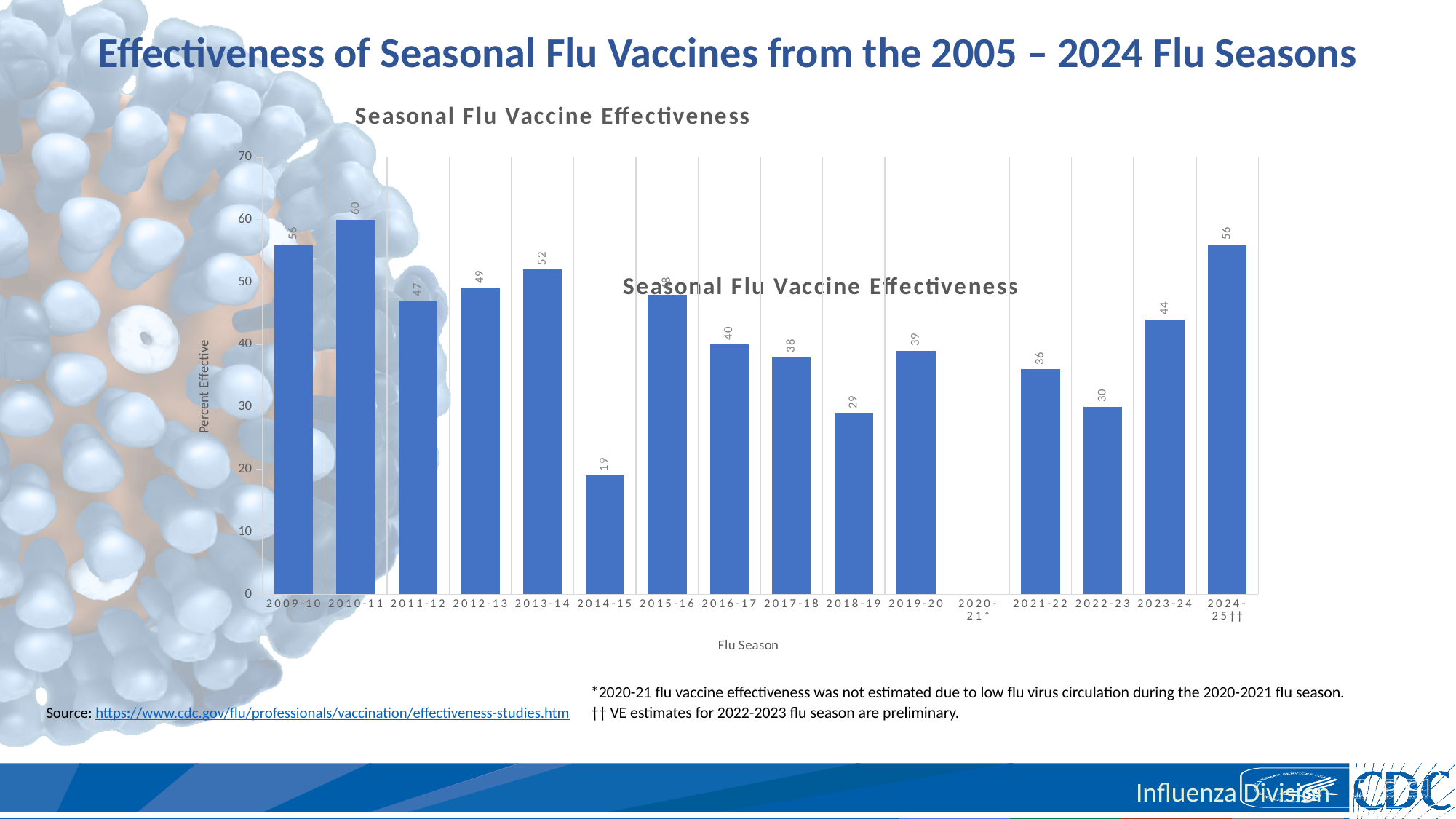
What is the vaccine effectiveness value for the 2023-24 flu season? 44 What is the vaccine effectiveness value for the 2014-15 flu season? 19 Which flu season has the highest vaccine effectiveness? 2010-11 Which flu season with a plotted bar has the lowest vaccine effectiveness? 2014-15 What is the difference between the vaccine effectiveness for 2010-11 and 2014-15? 41 Is the value for 2013-14 greater or less than 50? greater What is the vaccine effectiveness value for the 2010-11 flu season? 60 What kind of chart is shown on the slide? bar chart Which has a higher vaccine effectiveness, 2018-19 or 2022-23? 2022-23 What is the label of the y axis? Percent Effective How many flu seasons are labelled on the x axis? 16 Which flu season has no bar plotted? 2020-21*